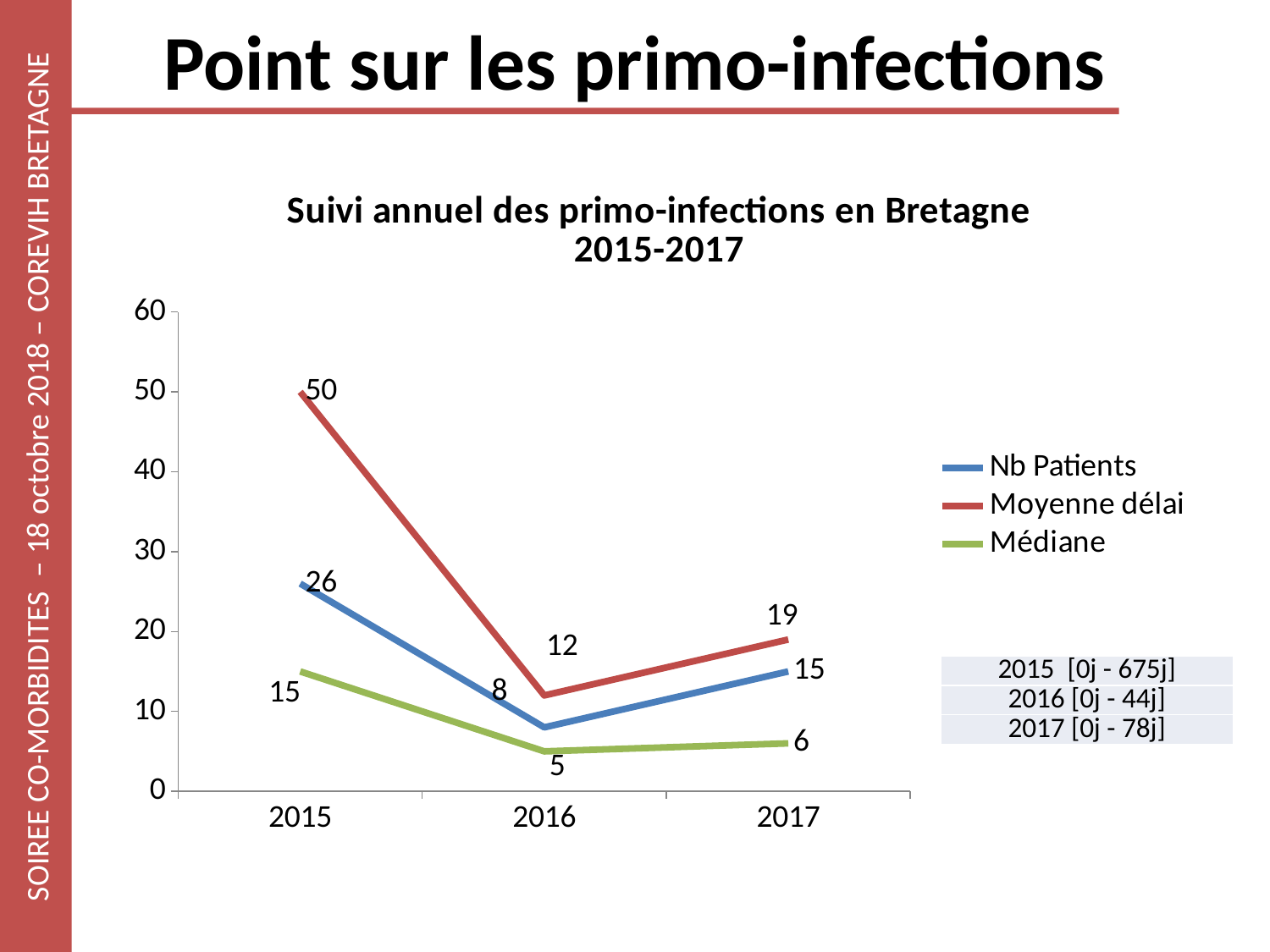
What is the value of Moyenne délai in 2016? 12 Does Médiane rise or fall from 2015 to 2016? fall What is the difference between Moyenne délai in 2015 and in 2017? 31 How many years are shown on the x axis? 3 In which year is Nb Patients lowest? 2016 What is the value of Nb Patients in 2015? 26 How many series does the legend list? 3 Which is larger in 2016: Nb Patients or Médiane? Nb Patients Is the value of Moyenne délai in 2015 greater or less than 40? greater What kind of chart is shown? line chart In which year is Moyenne délai highest? 2015 What is the value of Médiane in 2017? 6